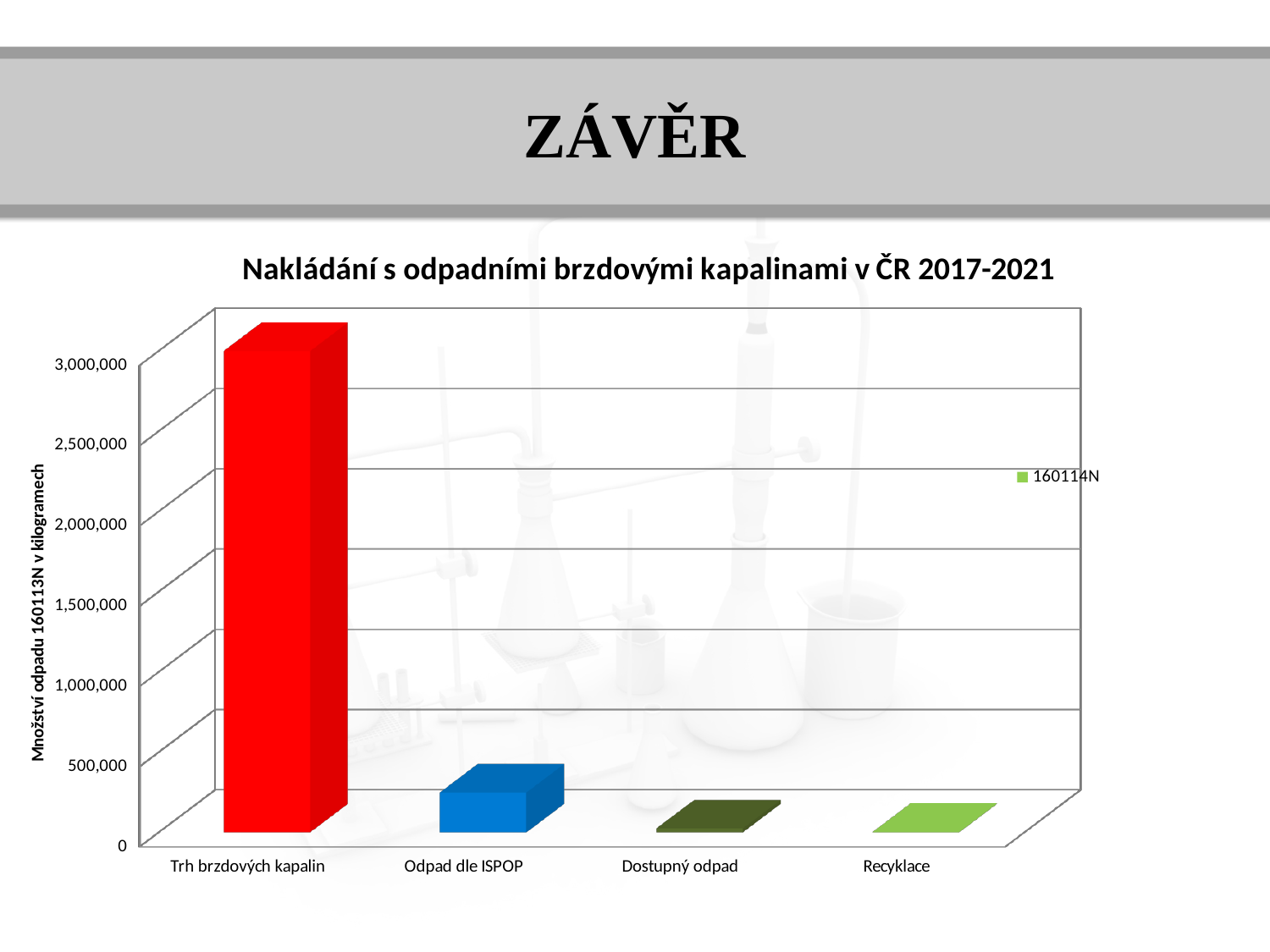
Is the value for Odpad dle ISPOP greater or less than 500,000? less What is the name of the series listed in the legend? 160114N How many series does the chart legend list? 1 Is the value for Trh brzdových kapalin greater or less than 2,500,000? greater How many categories are shown on the x axis of the chart? 4 Do the values generally rise or fall moving from left to right along the x axis? fall What type of chart is shown on the slide? Bar chart Is the value for Dostupný odpad greater or less than 500,000? less What is the title of the chart? Nakládání s odpadními brzdovými kapalinami v ČR 2017-2021 Which is larger, the value for Trh brzdových kapalin or the value for Odpad dle ISPOP? Trh brzdových kapalin Which category has the highest value in the chart? Trh brzdových kapalin